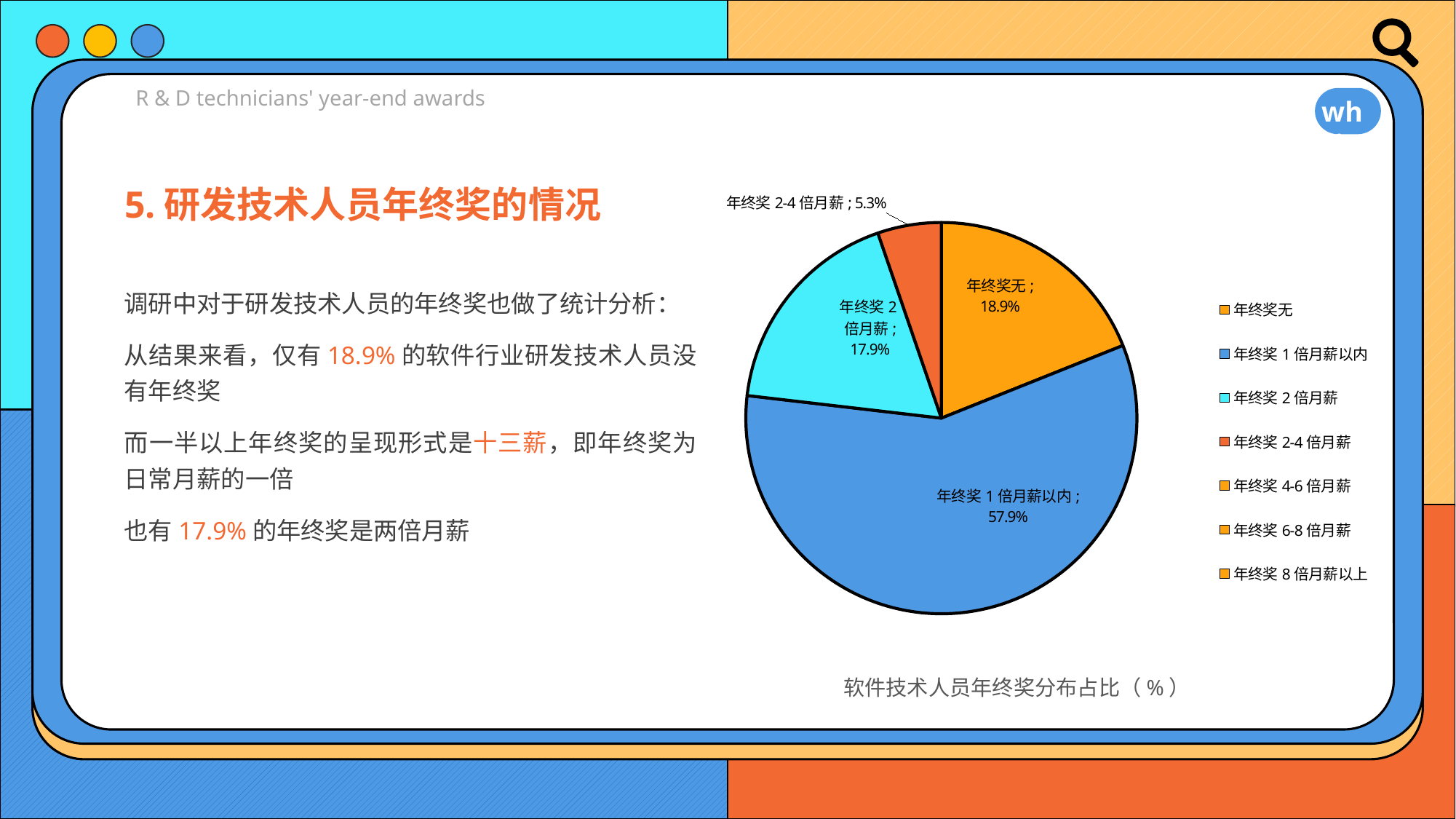
What type of chart is shown on the slide? pie chart What share of the pie is labelled for 年终奖 2-4 倍月薪? 5.3% What is the title of the pie chart? 软件技术人员年终奖分布占比（%） Which category has the largest slice of the pie? 年终奖 1 倍月薪以内 What share of the pie is labelled for 年终奖 2 倍月薪? 17.9% What share of the pie is labelled for 年终奖无? 18.9% What is the difference in percentage points between the 年终奖 1 倍月薪以内 slice and the 年终奖无 slice? 39.0 percentage points Which labelled slice of the pie is the smallest? 年终奖 2-4 倍月薪 How many slices with data labels are shown in the pie chart? 4 How many entries does the legend of the pie chart list? 7 What share of the pie is labelled for 年终奖 1 倍月薪以内? 57.9% Which slice is larger, 年终奖无 or 年终奖 2 倍月薪? 年终奖无